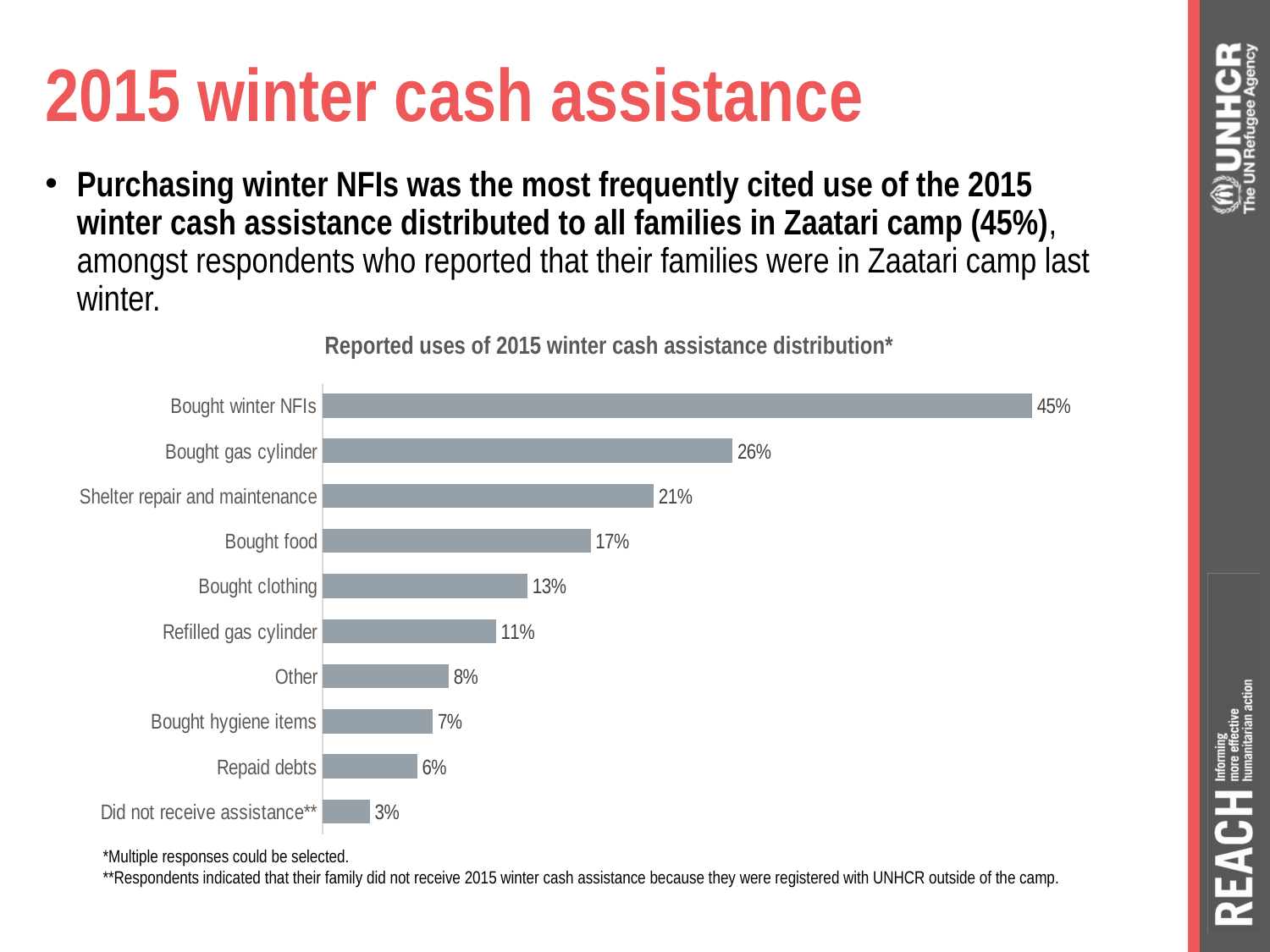
What is the difference between the values for 'Bought food' and 'Bought clothing'? 4 What is the value shown for 'Shelter repair and maintenance'? 21% What is the difference in percentage points between 'Bought winter NFIs' and 'Bought gas cylinder'? 19 Which is larger, the value for 'Refilled gas cylinder' or the value for 'Other'? Refilled gas cylinder What percentage is shown for 'Did not receive assistance**'? 3% What percentage of respondents reported 'Bought gas cylinder' as a use of the 2015 winter cash assistance? 26% Which is larger, 'Bought hygiene items' or 'Repaid debts'? Bought hygiene items What is the title of the chart? Reported uses of 2015 winter cash assistance distribution* Which category has the lowest value in the chart? Did not receive assistance** What type of chart is shown on the slide? Bar chart Which reported use of the 2015 winter cash assistance has the highest percentage? Bought winter NFIs How many categories are shown in the chart? 10